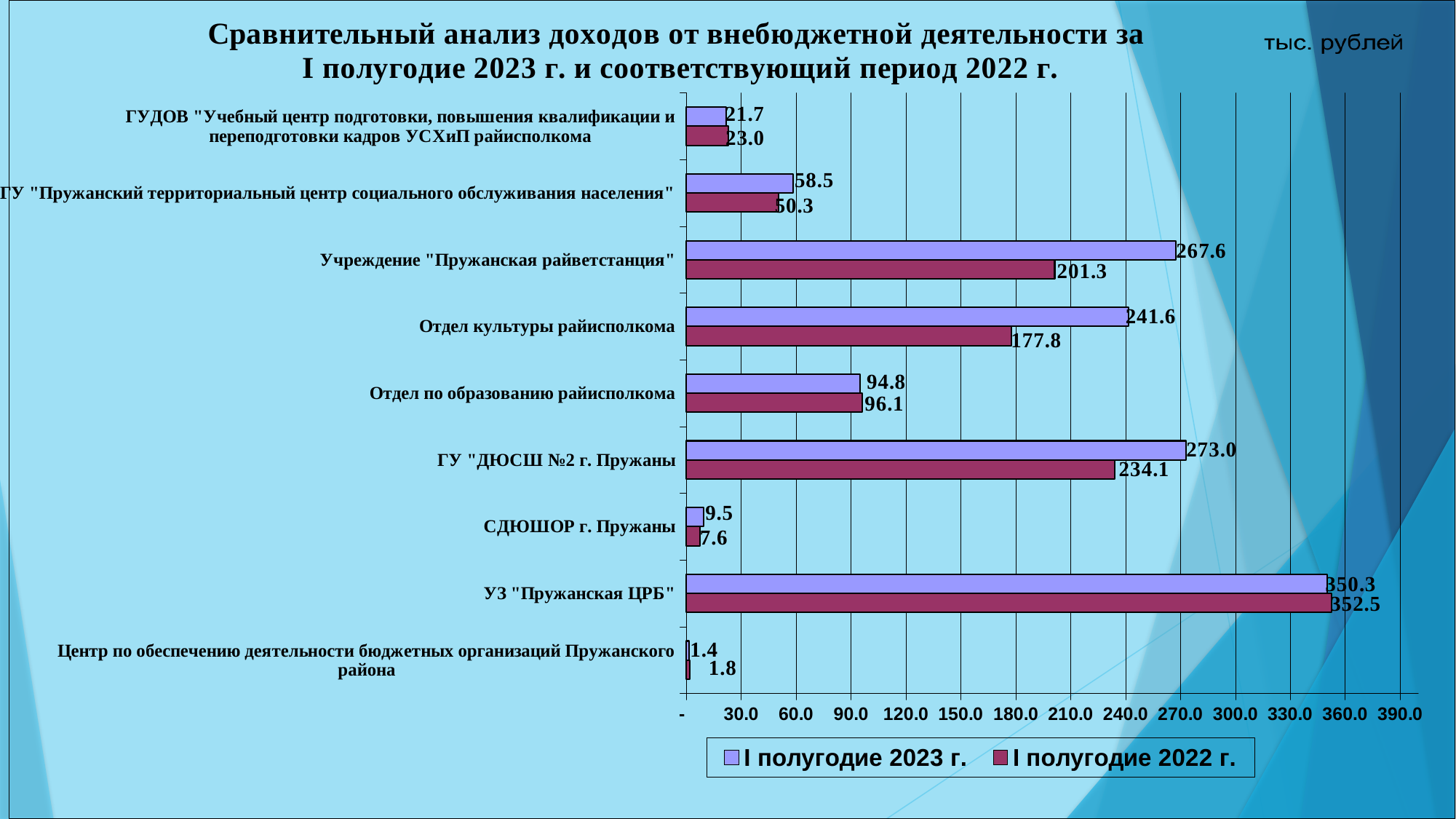
How many series does the legend list? 2 What is the value for Отдел культуры райисполкома in I полугодие 2022 г.? 177.8 What is the value for СДЮШОР г. Пружаны in I полугодие 2022 г.? 7.6 Which organisation has the highest value in I полугодие 2023 г.? УЗ "Пружанская ЦРБ" Which organisation has the lowest value in I полугодие 2022 г.? Центр по обеспечению деятельности бюджетных организаций Пружанского района For Отдел по образованию райисполкома, which is larger: the I полугодие 2023 г. value or the I полугодие 2022 г. value? I полугодие 2022 г. What is the value for ГУ "ДЮСШ №2 г. Пружаны" in I полугодие 2023 г.? 273.0 What is the value for УЗ "Пружанская ЦРБ" in I полугодие 2023 г.? 350.3 How many organisations (categories) are plotted on the chart? 9 What kind of chart is shown on the slide? bar chart What is the difference between the I полугодие 2023 г. and I полугодие 2022 г. values for Учреждение "Пружанская райветстанция"? 66.3 What unit is indicated in the top right corner of the chart? тыс. рублей